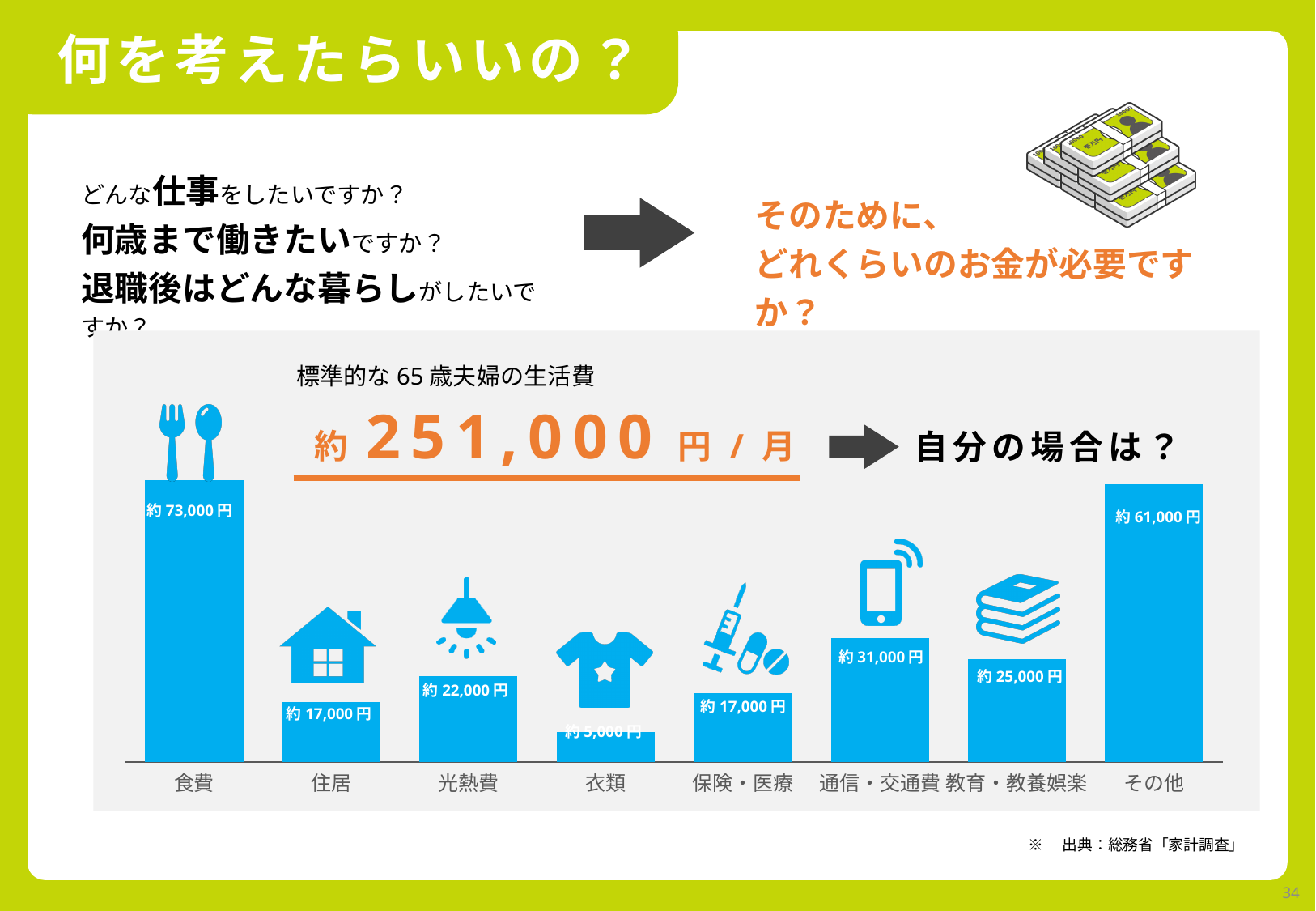
What is the value shown for 教育・教養娯楽 in the bar chart? 約25,000円 Which category has the lowest value in the bar chart? 衣類 Which is larger, the value for 通信・交通費 or the value for 教育・教養娯楽? 通信・交通費 What is the value shown for 通信・交通費 in the bar chart? 約31,000円 What kind of chart is shown on the slide? Bar chart What is the value shown for その他 in the bar chart? 約61,000円 What is the difference between the values for 食費 and その他? 12,000円 What is the value shown for 食費 in the bar chart? 約73,000円 How many categories are shown in the bar chart? 8 What is the value shown for 光熱費 in the bar chart? 約22,000円 Which category has the highest value in the bar chart? 食費 What is the title of the chart on the slide? 標準的な65歳夫婦の生活費